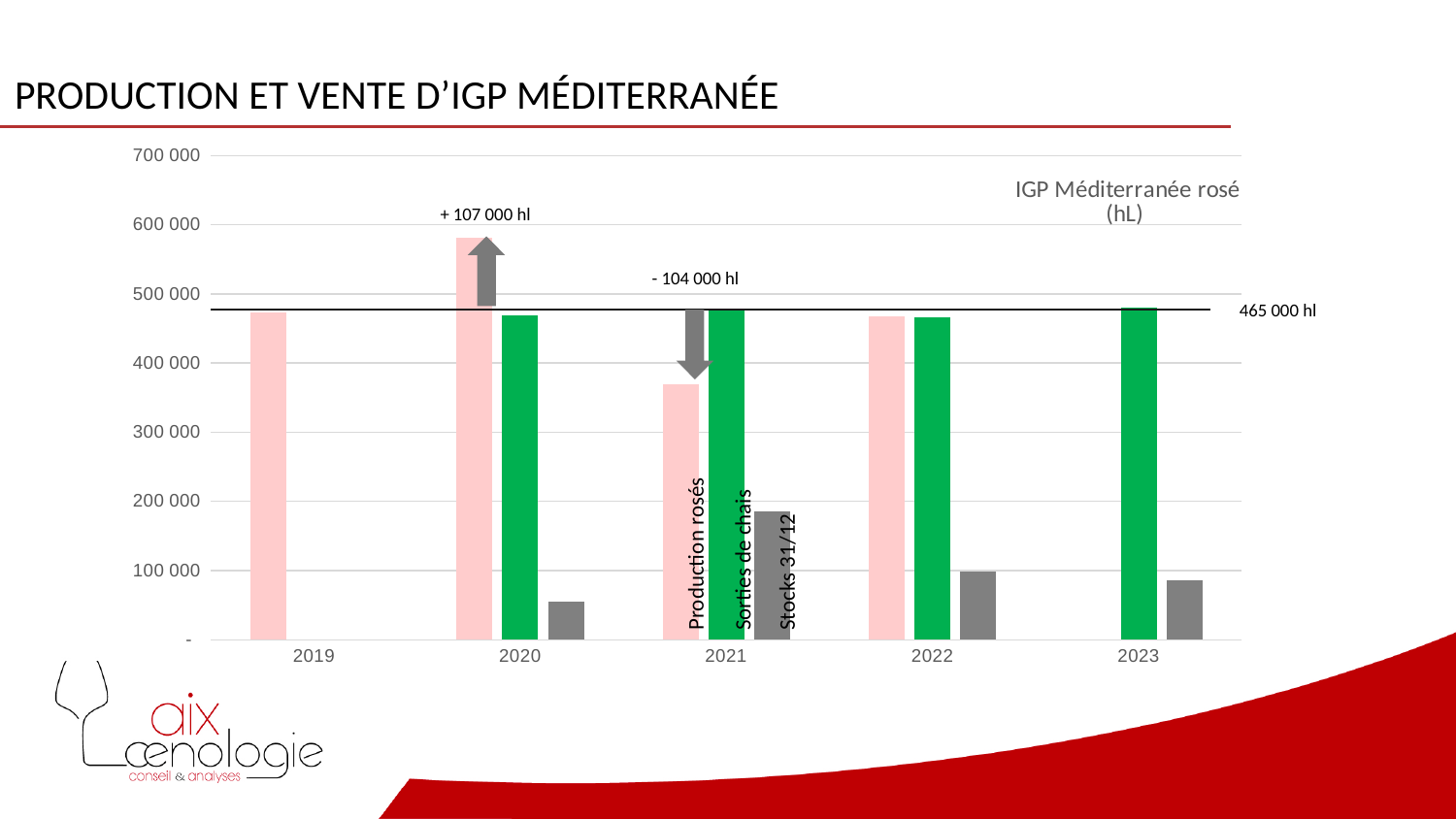
What is the title of the chart? IGP Méditerranée rosé (hL) Do the Stocks 31/12 values rise or fall from 2021 to 2023? fall Which year has the highest Stocks 31/12 bar? 2021 Is the Production rosés value for 2021 greater or less than 400 000? less Which year has the lowest Production rosés bar? 2021 How many years are shown on the x axis of the chart? 5 What value is labelled on the horizontal reference line across the chart? 465 000 hl Is the Production rosés value for 2020 greater or less than 500 000? greater How many data series are labelled on the chart? 3 Is the Stocks 31/12 value for 2020 greater or less than 100 000? less What kind of chart is shown on the slide? bar chart Which year has the highest Production rosés bar? 2020